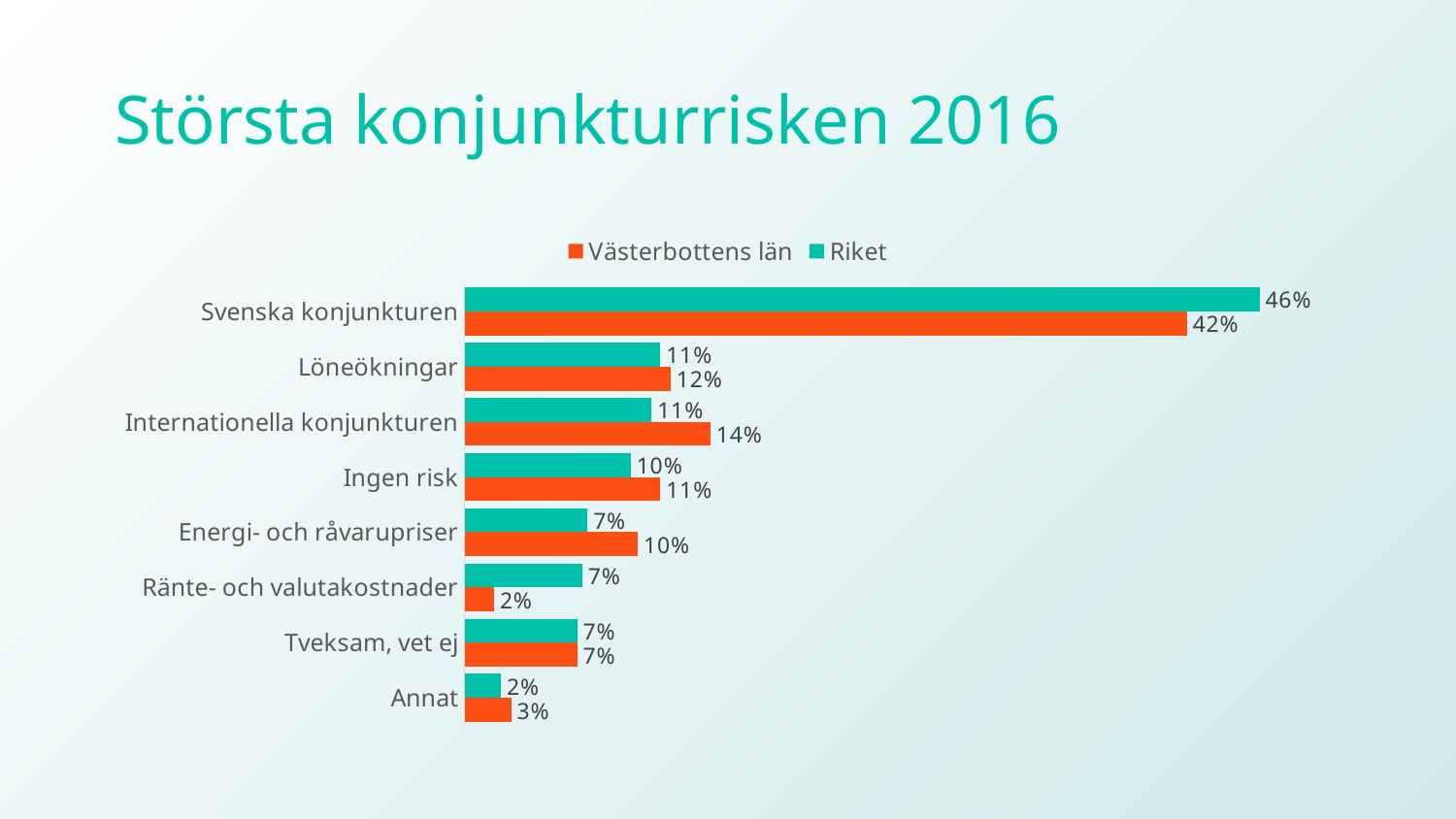
What is the value for Västerbottens län for Ränte- och valutakostnader? 2% Which category has the highest value for Västerbottens län? Svenska konjunkturen How many categories are shown in the chart? 8 What is the title of the chart? Största konjunkturrisken 2016 What is the value for Västerbottens län for Internationella konjunkturen? 14% How many series does the legend list? 2 What is the difference between Riket and Västerbottens län for Ränte- och valutakostnader? 5% Which category has the lowest value for Riket? Annat What is the difference between Riket and Västerbottens län for Svenska konjunkturen? 4% What is the value for Riket for Svenska konjunkturen? 46% What kind of chart is shown on the slide? Bar chart Which is larger for Energi- och råvarupriser, Västerbottens län or Riket? Västerbottens län